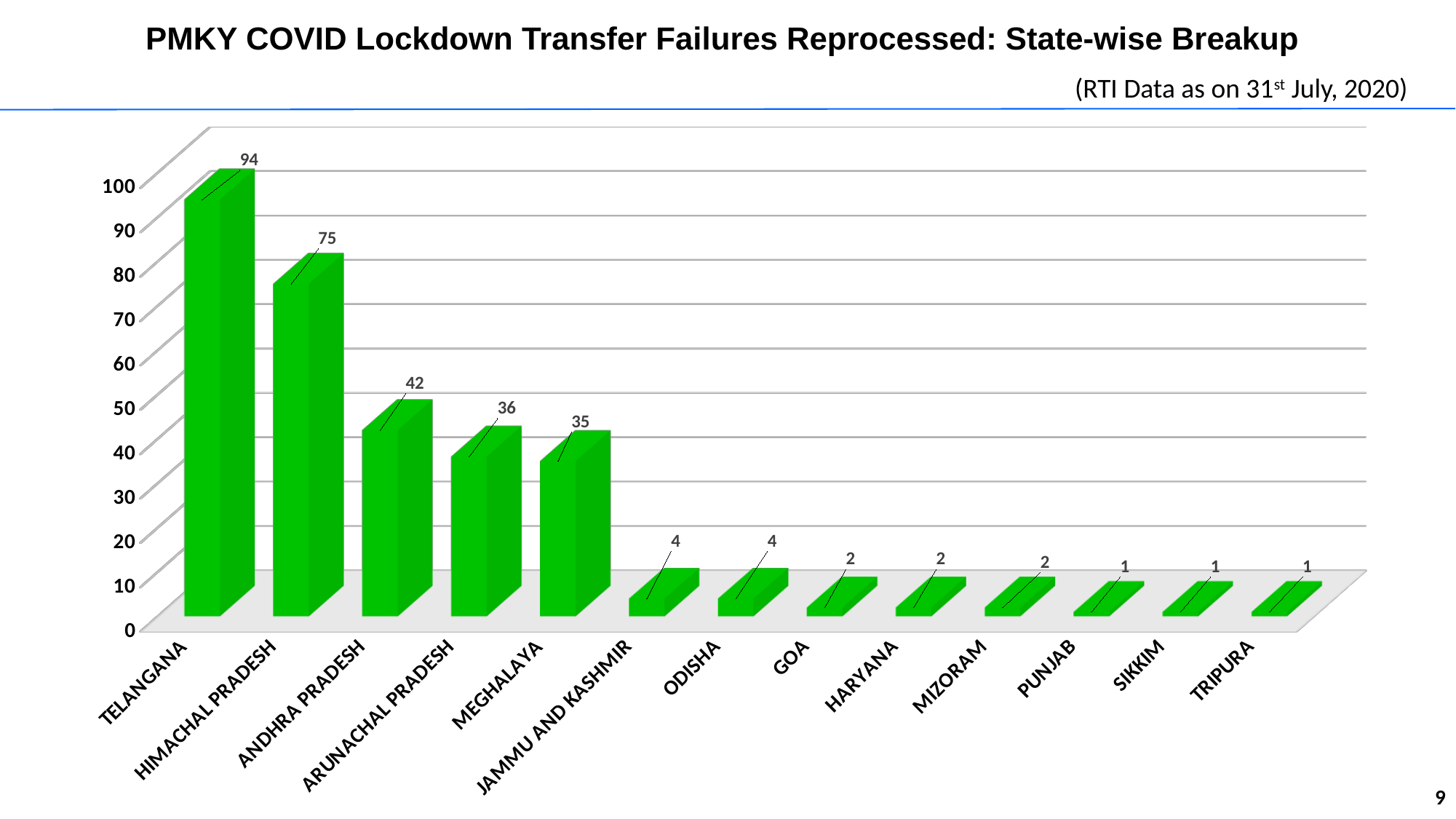
What is the value for Odisha? 4 What is the difference between the values for Andhra Pradesh and Arunachal Pradesh? 6 How many states are shown on the chart? 13 What is the value for Himachal Pradesh? 75 What is the value for Telangana? 94 What is the difference between the values for Telangana and Himachal Pradesh? 19 What is the value for Meghalaya? 35 Which state has the highest value? Telangana What is the title of the chart? PMKY COVID Lockdown Transfer Failures Reprocessed: State-wise Breakup Do the values rise or fall from left to right along the x axis? Fall What kind of chart is shown on the slide? Bar chart Which is larger, the value for Andhra Pradesh or the value for Meghalaya? Andhra Pradesh